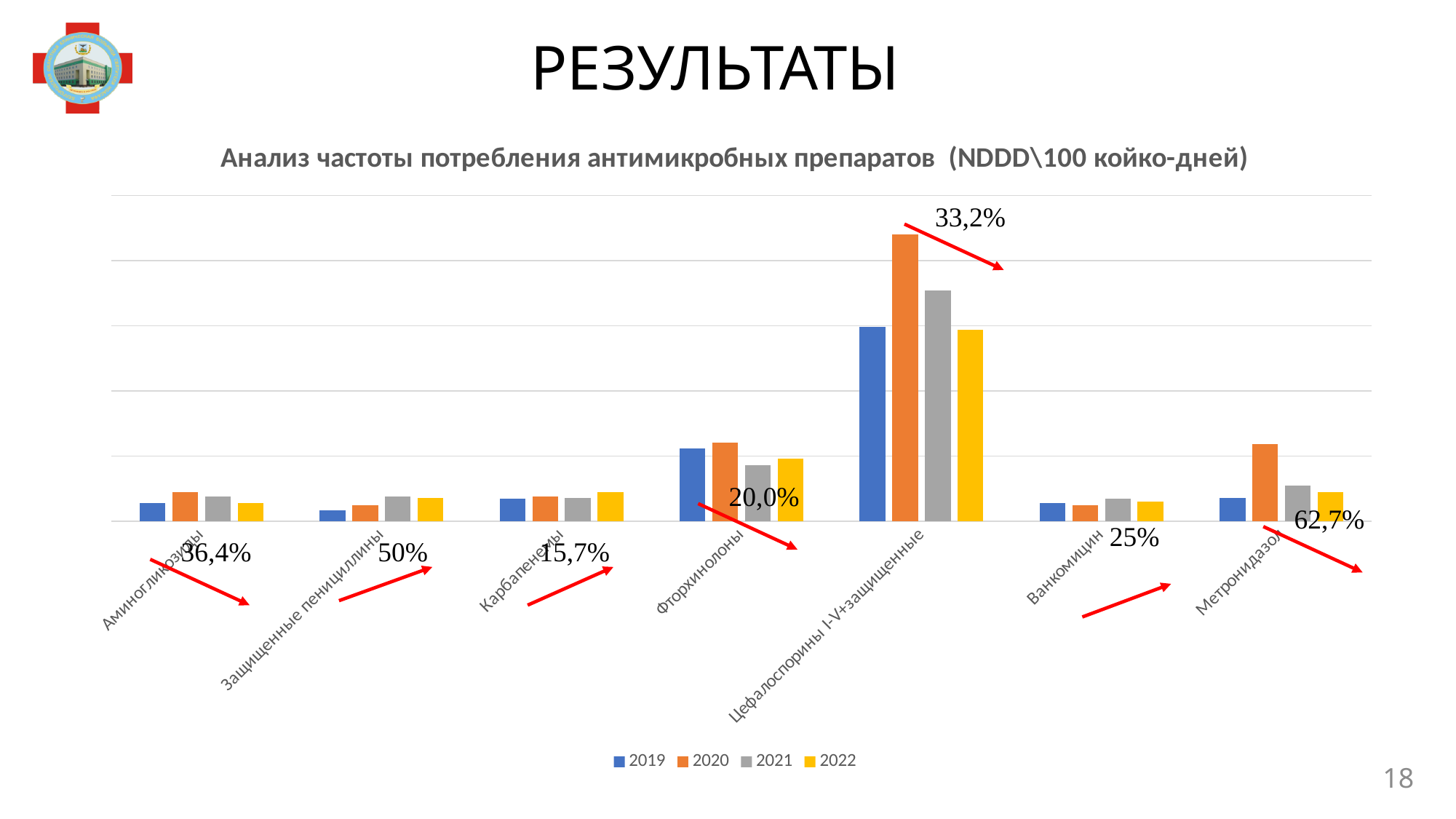
How many series does the legend list? 4 Which is larger: the 2020 bar for Цефалоспорины I-V+защищенные or the 2020 bar for Метронидазол? Цефалоспорины I-V+защищенные What percentage is annotated next to the Метронидазол bars? 62,7% Which drug category has the highest bars overall? Цефалоспорины I-V+защищенные Which is larger: the 2019 bar for Фторхинолоны or the 2019 bar for Аминогликозиды? Фторхинолоны For Цефалоспорины I-V+защищенные, which year has the highest bar? 2020 From 2020 to 2022, do the bars for Цефалоспорины I-V+защищенные rise or fall? fall For Фторхинолоны, which year has the lowest bar? 2021 Which colour represents the 2022 series in the legend? yellow How many drug categories are shown on the x axis? 7 What kind of chart is shown on the slide? bar chart For Метронидазол, which year has the highest bar? 2020